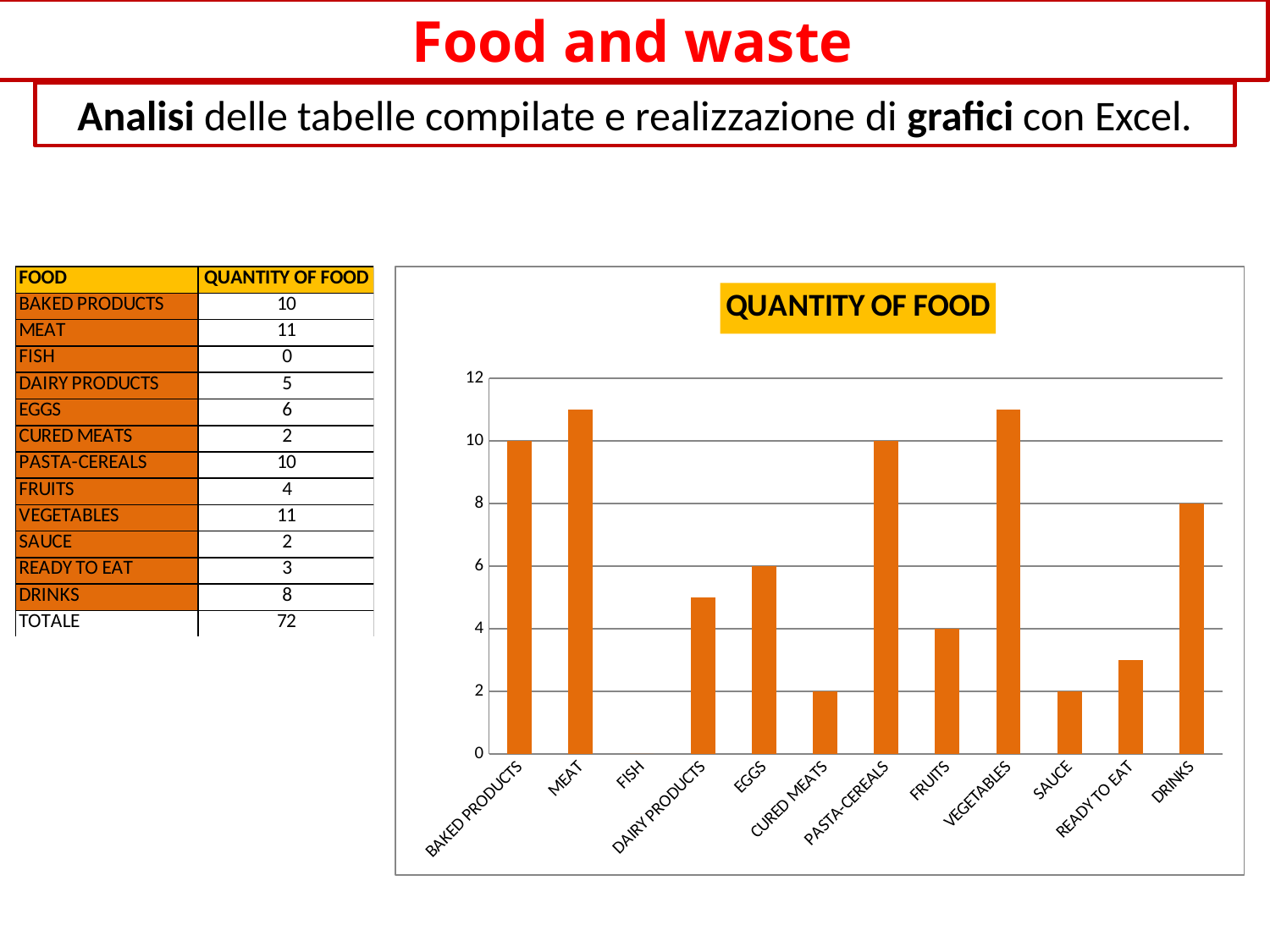
What is the value for DRINKS in the QUANTITY OF FOOD chart? 8 What is the value for PASTA-CEREALS in the QUANTITY OF FOOD chart? 10 What is the value for DAIRY PRODUCTS in the QUANTITY OF FOOD chart? 5 How many categories are shown on the x axis of the QUANTITY OF FOOD chart? 12 What colour are the bars in the QUANTITY OF FOOD chart? orange What is the difference between the values for MEAT and FRUITS in the QUANTITY OF FOOD chart? 7 Which is larger in the QUANTITY OF FOOD chart, EGGS or READY TO EAT? EGGS What kind of chart is the QUANTITY OF FOOD chart? bar chart What is the total of all the values plotted in the QUANTITY OF FOOD chart? 72 What is the title of the chart on the slide? QUANTITY OF FOOD Is the value for VEGETABLES in the QUANTITY OF FOOD chart greater or less than 10? greater Which category has the lowest value in the QUANTITY OF FOOD chart? FISH